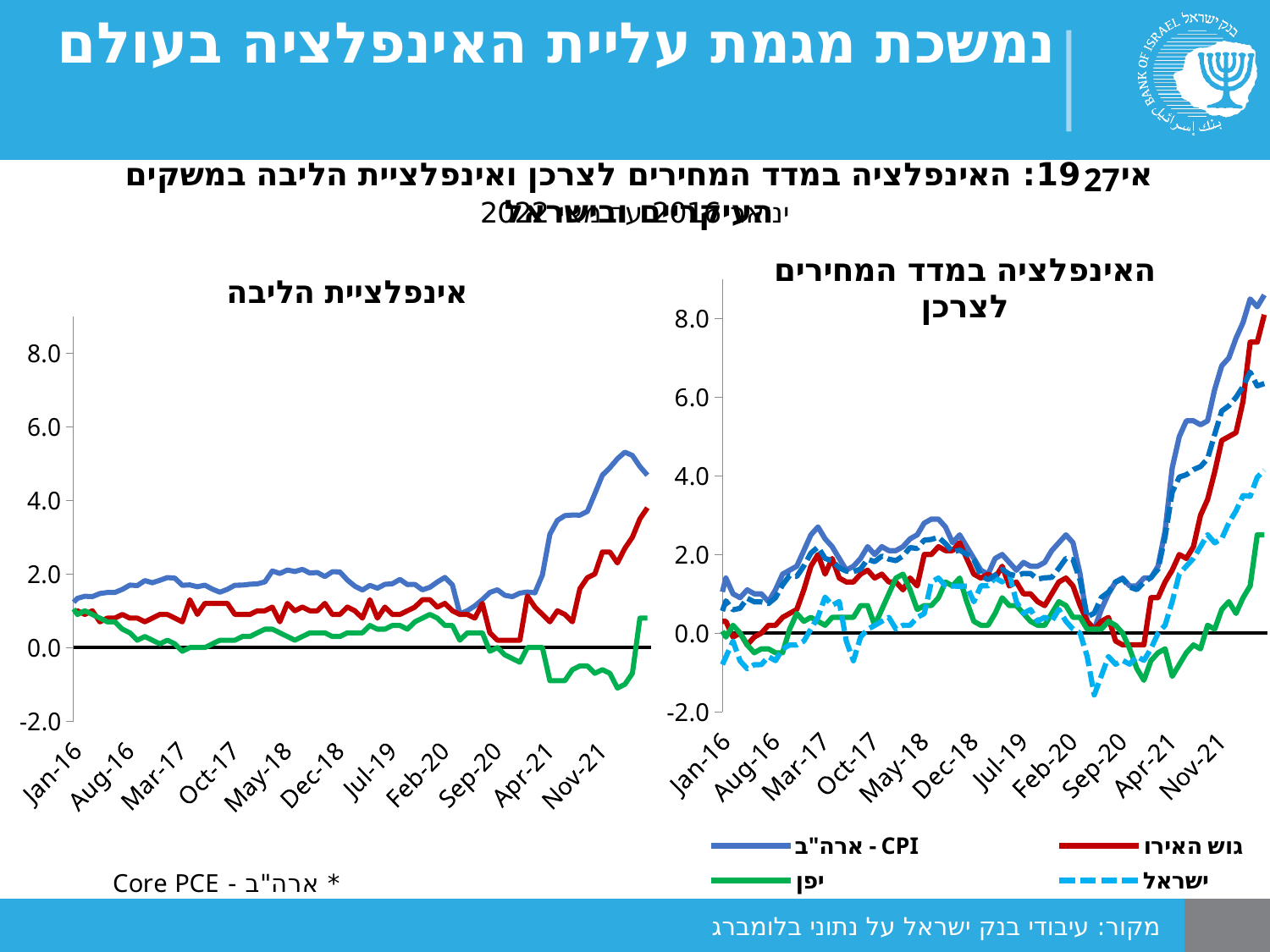
In the left chart (core inflation), which series is lowest at the end of the period (Nov-21)? יפן In the left chart (core inflation), which series is highest at the end of the period (Nov-21)? ארה"ב How many date labels are shown on the x axis of the left chart? 11 What kind of chart is the right chart titled "האינפלציה במדד המחירים לצרכן"? line chart How many series does the legend at the bottom of the slide list? 4 What kind of chart is the left chart titled "אינפלציית הליבה"? line chart In the right chart (CPI inflation), which series is highest at the end of the period (Nov-21)? CPI - ארה"ב In the right chart (CPI inflation), do the values for CPI - ארה"ב rise or fall from Sep-20 to Nov-21? rise In the right chart (CPI inflation), which series is lowest at the end of the period (Nov-21)? יפן In the left chart (core inflation), is the value for ארה"ב at the end of the period greater or less than 4.0? greater